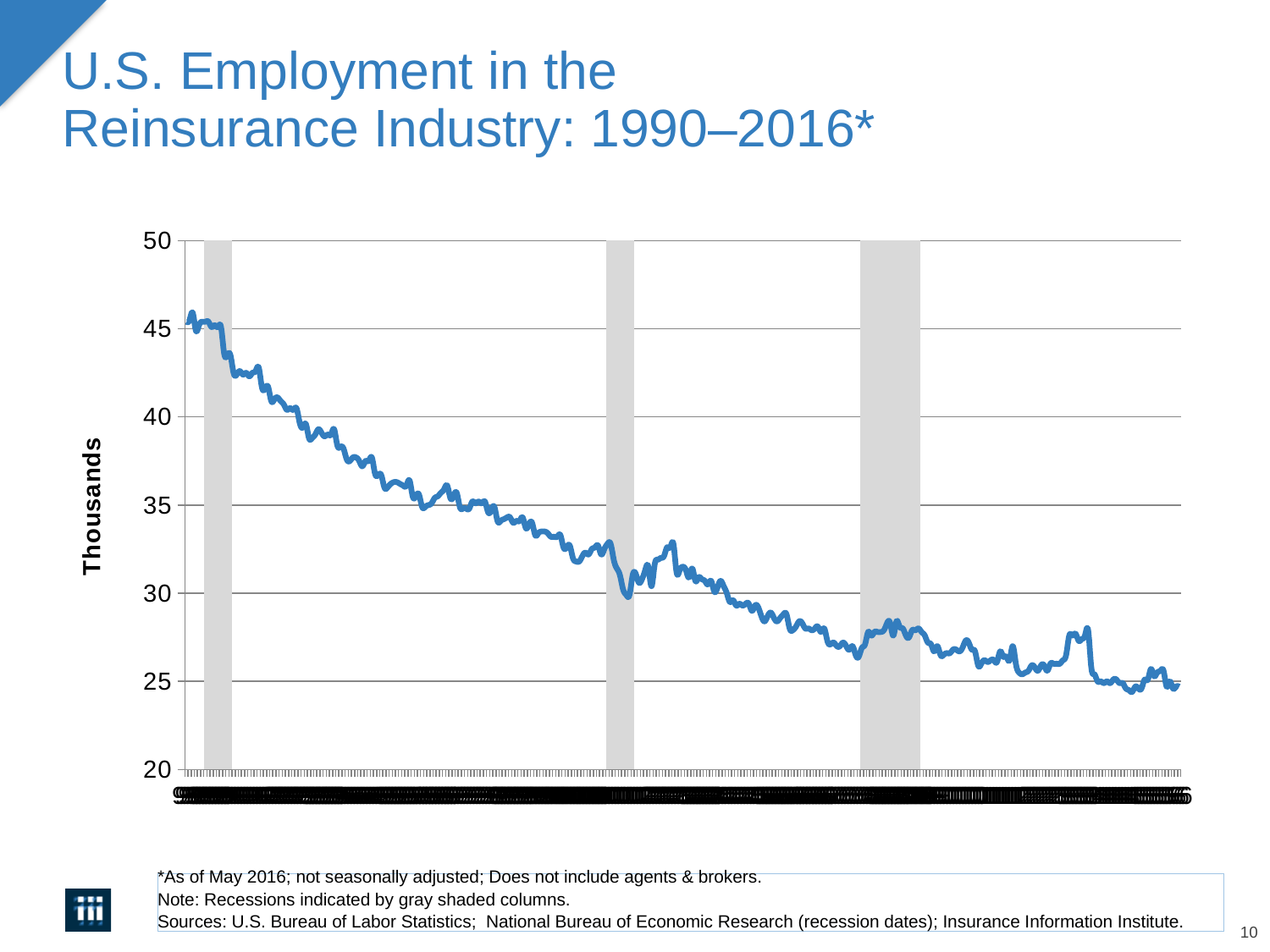
What kind of chart is shown on the slide? line chart What is the highest value shown on the vertical axis? 50 Is the value at the start of the series (left end of the line) greater or less than 40? greater What is the label on the vertical axis of the chart? Thousands What is the lowest value shown on the vertical axis? 20 How many data series (lines) are plotted on the chart? 1 Overall, do the values rise or fall from left to right along the x axis? fall Is the value at the end of the series greater or less than 20? greater Is the value at the start of the series greater or less than 50? less